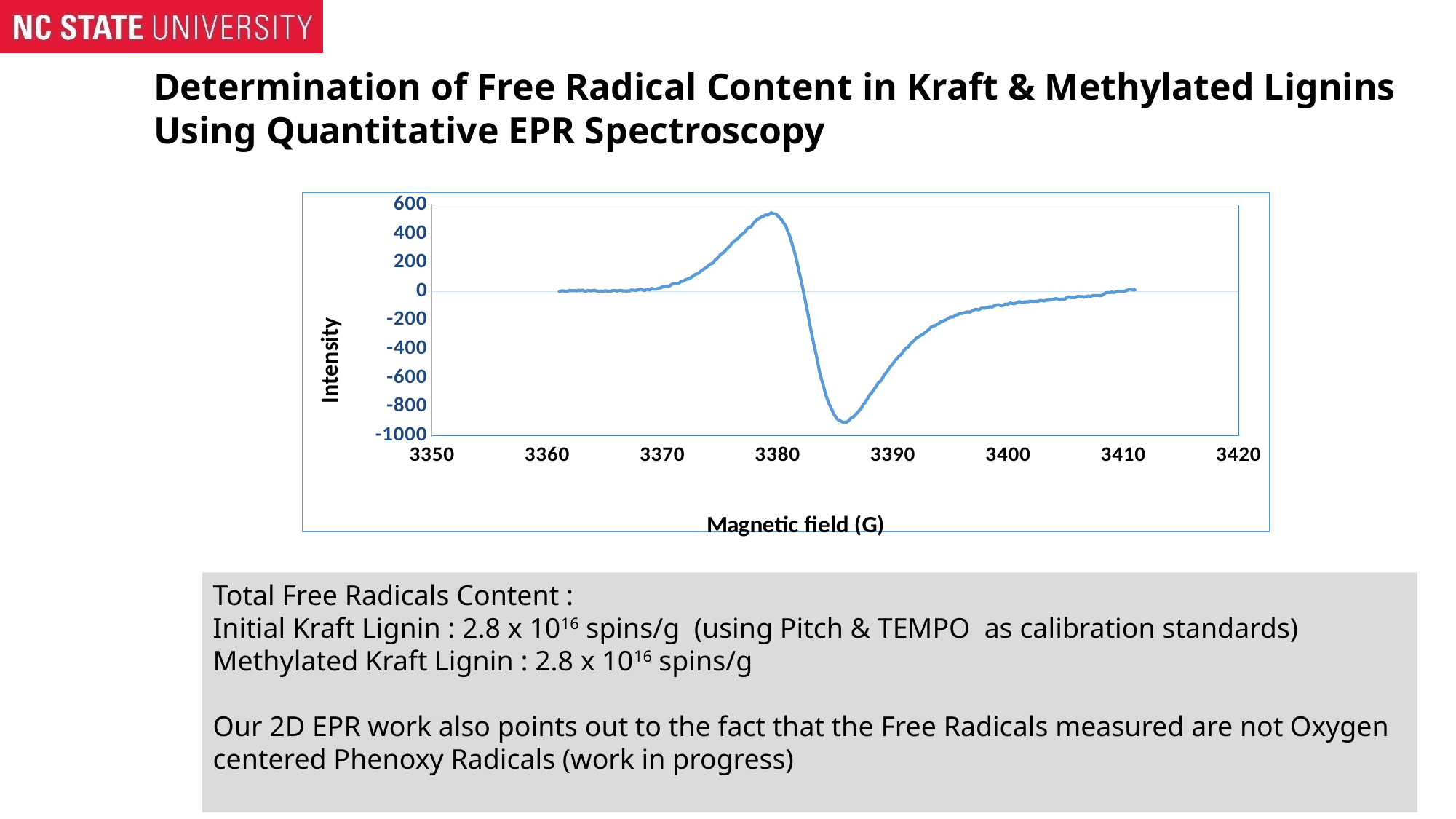
What is the title of the y axis of the chart? Intensity What is the title of the x axis of the chart? Magnetic field (G) What kind of chart is shown on the slide? line chart Is the intensity at a magnetic field of 3390 G greater or less than -200? less Is the maximum intensity reached by the curve greater or less than 400? greater How many lines (series) are plotted on the chart? 1 Does the intensity rise or fall as the magnetic field increases from 3380 G to 3386 G? fall Is the minimum intensity reached by the curve greater or less than -800? less Does the intensity rise or fall as the magnetic field increases from 3390 G to 3410 G? rise